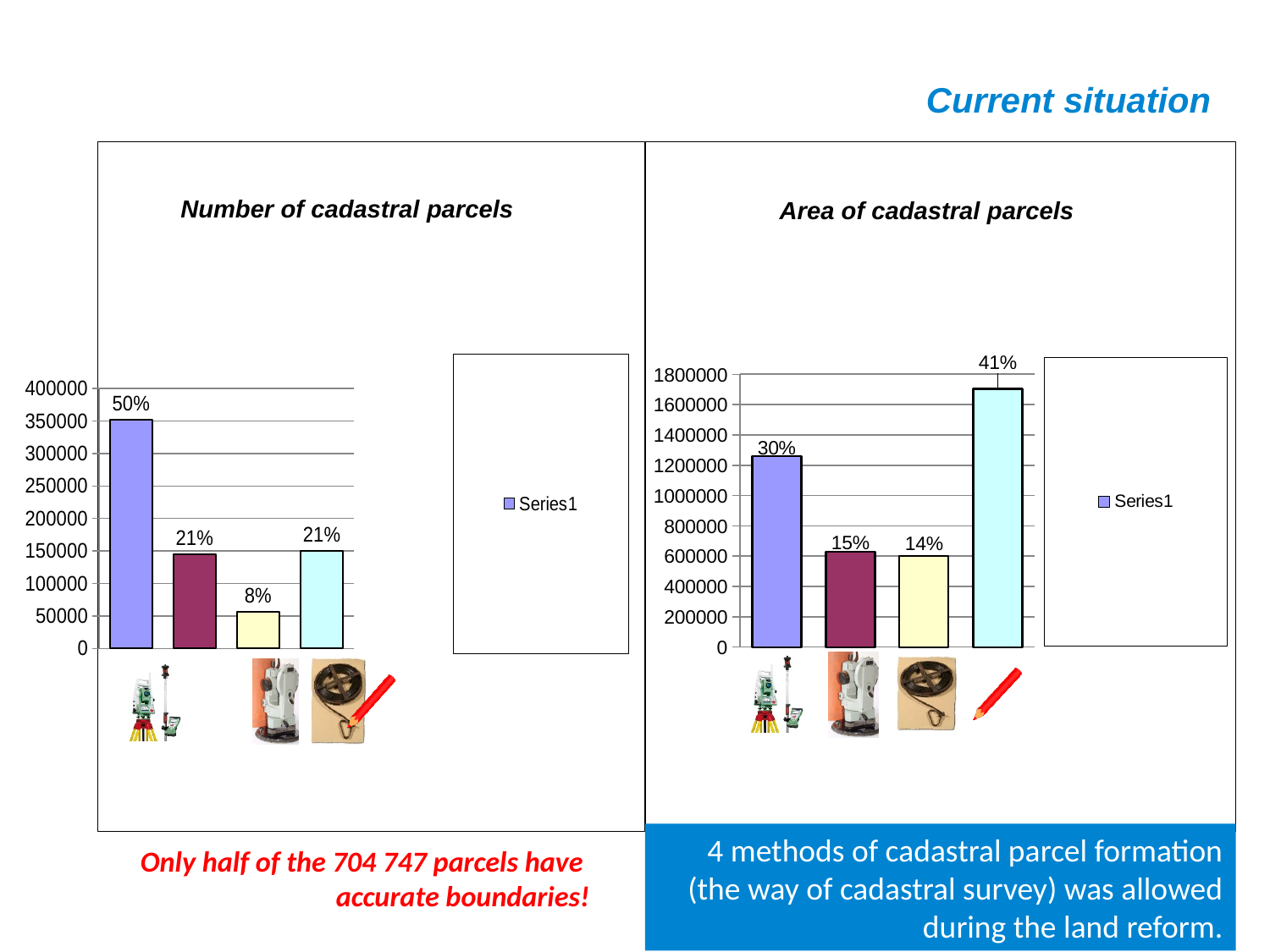
On the 'Number of cadastral parcels' chart, is the value of the third (yellow) bar greater or less than 100000? less On the 'Area of cadastral parcels' chart, which bar has the highest value? the fourth (light blue) bar On the 'Number of cadastral parcels' chart, what percentage label is shown on the third (yellow) bar? 8% On the 'Area of cadastral parcels' chart, what percentage label is shown on the fourth (light blue) bar? 41% What type of chart is the 'Area of cadastral parcels' chart? bar chart How many bars are plotted on the 'Area of cadastral parcels' chart? 4 How many series does the legend of the 'Number of cadastral parcels' chart list? 1 On the 'Number of cadastral parcels' chart, what is the difference between the percentage labels of the first bar and the third bar? 42% On the 'Number of cadastral parcels' chart, what percentage label is shown on the first (blue) bar? 50% On the 'Number of cadastral parcels' chart, which bar has the lowest value? the third (yellow) bar On the 'Area of cadastral parcels' chart, what percentage label is shown on the second (purple) bar? 15% On the 'Area of cadastral parcels' chart, is the value of the first (blue) bar greater or less than 1000000? greater